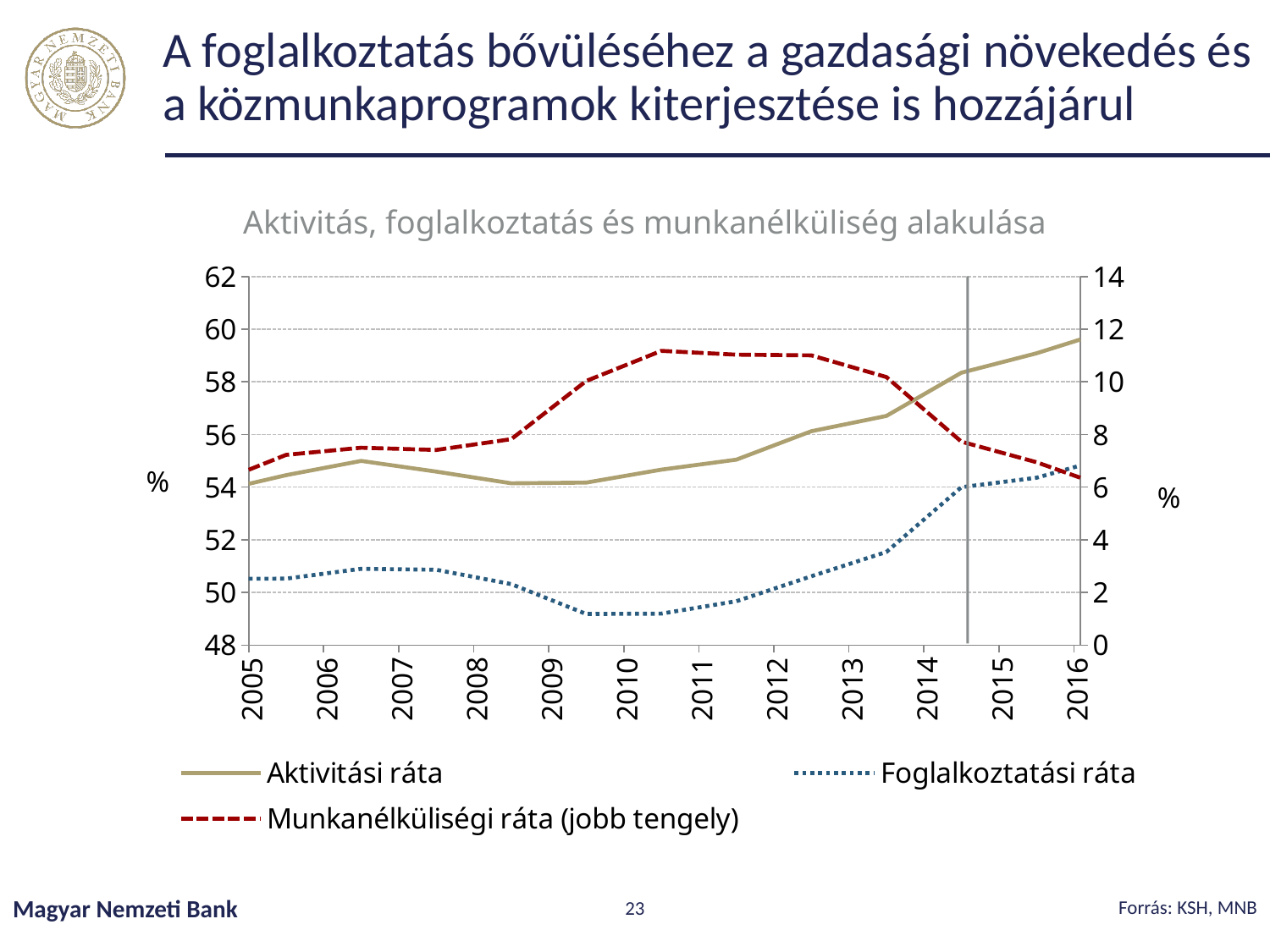
Does Aktivitási ráta rise or fall between 2010 and 2016? rise Is the value of Foglalkoztatási ráta in 2010 greater or less than 50? less Is the value of Munkanélküliségi ráta in 2011 greater or less than 10? greater How many series does the legend list? 3 How many years are labelled on the x axis? 12 Is the value of Aktivitási ráta in 2016 greater or less than 58? greater What kind of chart is shown on the slide? line chart In 2005, which is higher: Aktivitási ráta or Foglalkoztatási ráta? Aktivitási ráta What is the title of the chart? Aktivitás, foglalkoztatás és munkanélküliség alakulása Does Munkanélküliségi ráta rise or fall between 2013 and 2016? fall Which series is plotted on the right axis? Munkanélküliségi ráta